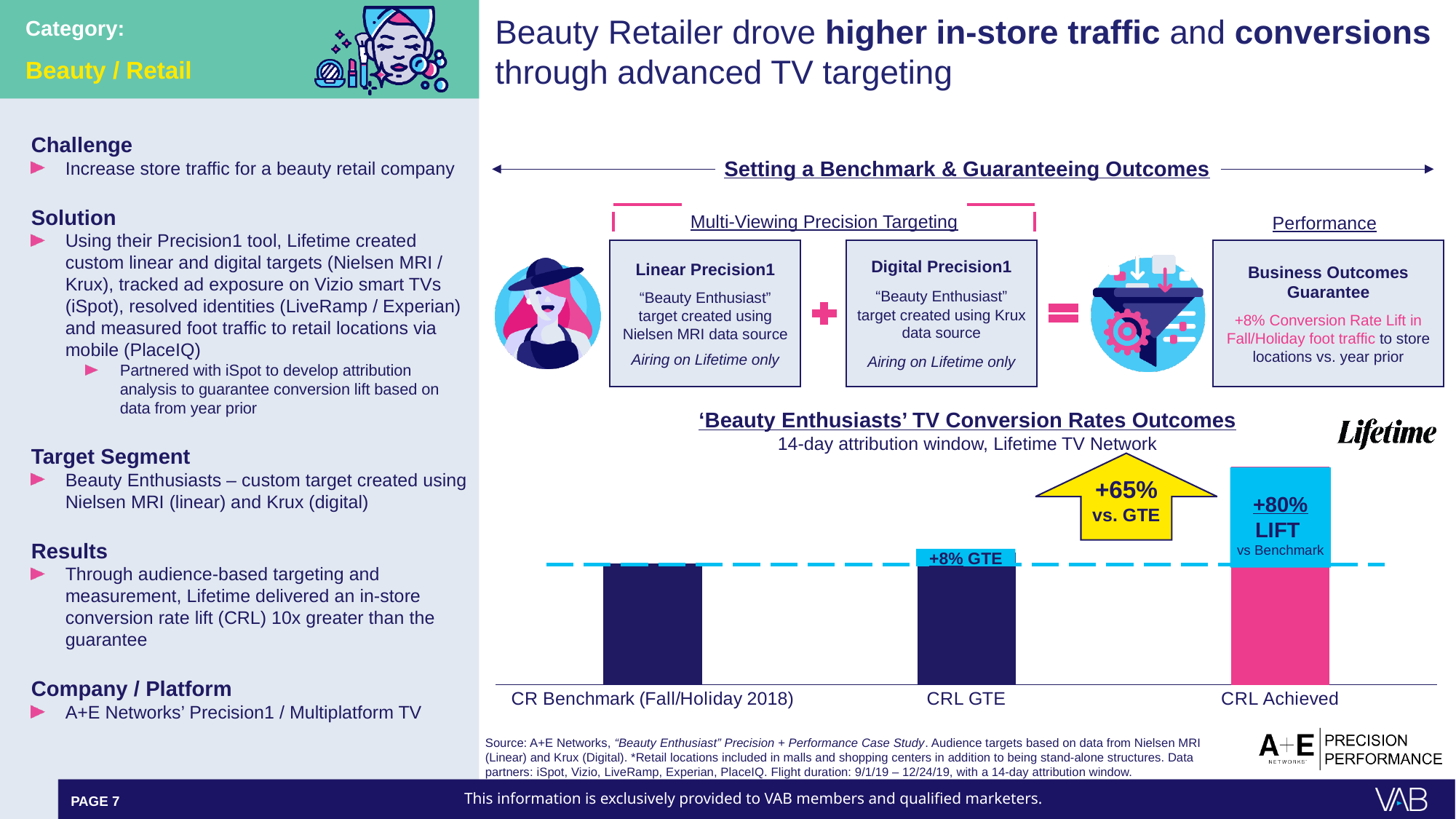
What lift vs benchmark is labelled on the CRL Achieved bar? +80% What attribution window is stated in the subtitle of the conversion rates chart? 14-day attribution window Which bar is taller, CR Benchmark (Fall/Holiday 2018) or CRL Achieved? CRL Achieved Do the bar heights rise or fall from left to right across the conversion rates chart? Rise Which bar is taller in the conversion rates chart, CRL GTE or CRL Achieved? CRL Achieved Which bar is the tallest in the 'Beauty Enthusiasts' TV Conversion Rates Outcomes chart? CRL Achieved What kind of chart is shown under the title 'Beauty Enthusiasts' TV Conversion Rates Outcomes? Bar chart What lift is labelled on the CRL GTE bar in the conversion rates chart? +8% GTE What does the yellow arrow above the chart say the CRL Achieved result is versus the GTE? +65% vs. GTE What is the label of the first (leftmost) bar in the conversion rates chart? CR Benchmark (Fall/Holiday 2018) How many bars are plotted in the 'Beauty Enthusiasts' TV Conversion Rates Outcomes chart? 3